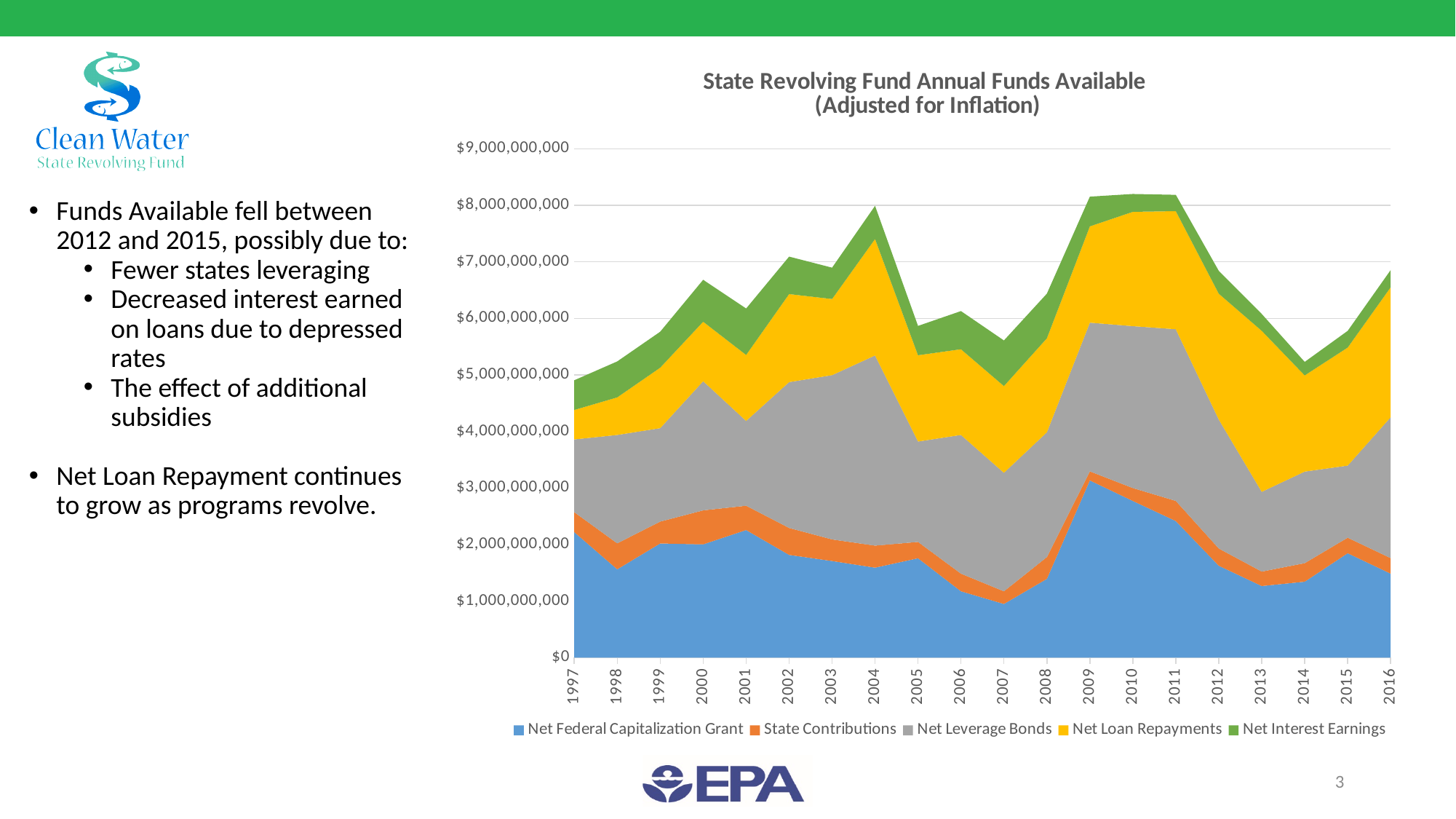
Which year has the larger total funds available, 2010 or 2007? 2010 Does the total funds available rise or fall from 2012 to 2014? fall What kind of chart is shown on the slide? Stacked area chart Which series is plotted at the bottom of the stack in the chart? Net Federal Capitalization Grant Is the Net Federal Capitalization Grant value in 2001 greater or less than $2,000,000,000? greater Does the total funds available rise or fall from 2014 to 2016? rise Is the total funds available in 1997 greater or less than $5,000,000,000? less Is the total funds available in 2010 greater or less than $7,000,000,000? greater How many series does the chart legend list? 5 How many years are plotted along the x axis of the chart? 20 What is the title of the chart? State Revolving Fund Annual Funds Available (Adjusted for Inflation)